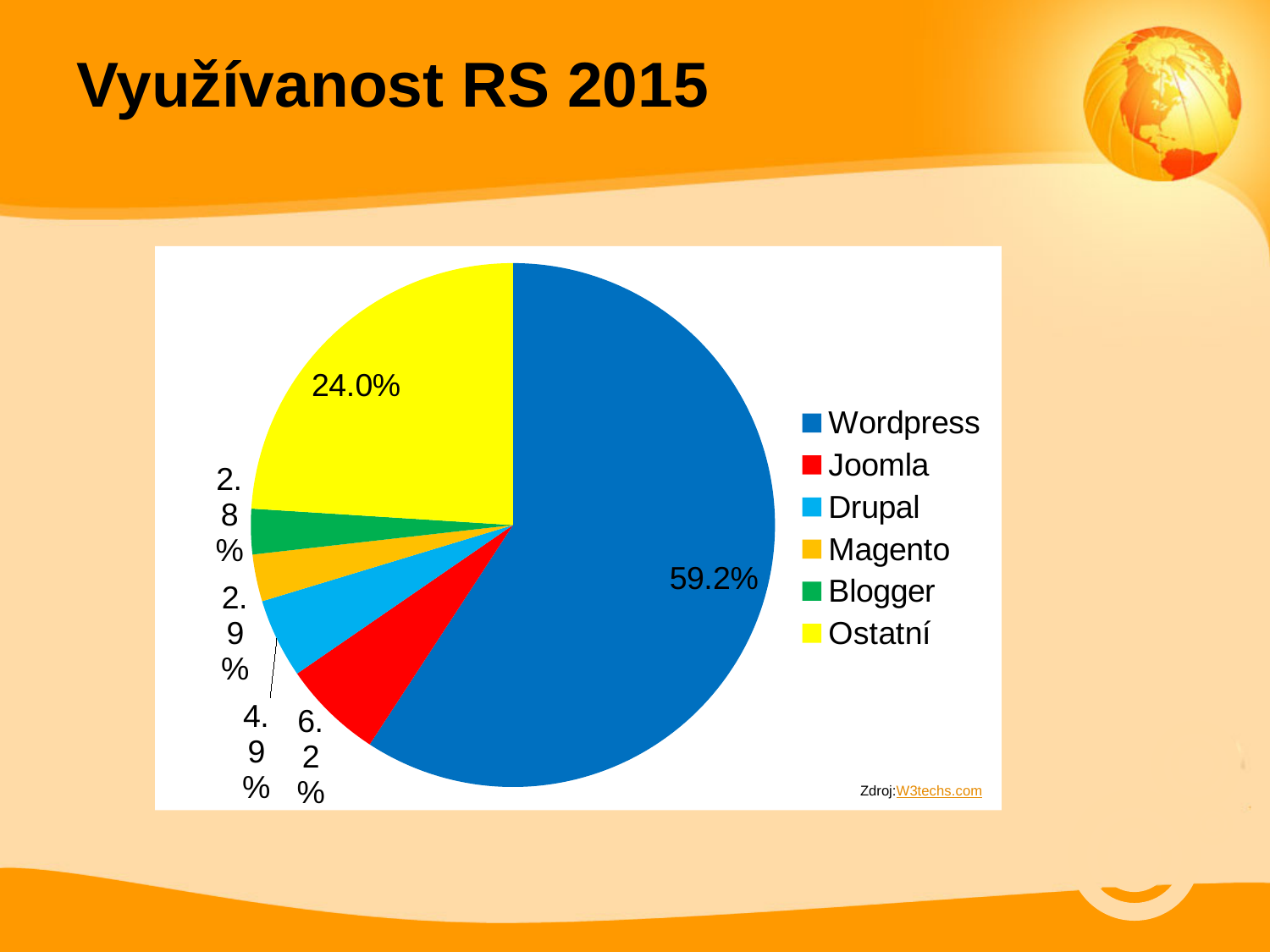
What share of the pie does Wordpress have? 59.2% How many entries does the legend list? 6 Which category has the smallest slice of the pie? Blogger What is the value shown for Drupal? 4.9% What kind of chart is shown on the slide? pie chart What is the difference between the Wordpress share and the Ostatní share? 35.2% Which category has the largest slice of the pie? Wordpress What is the value shown for Joomla? 6.2% Which is larger, the Joomla slice or the Drupal slice? Joomla What is the title of the slide containing the chart? Využívanost RS 2015 How many slices does the pie chart have? 6 What share of the pie does Ostatní have? 24.0%